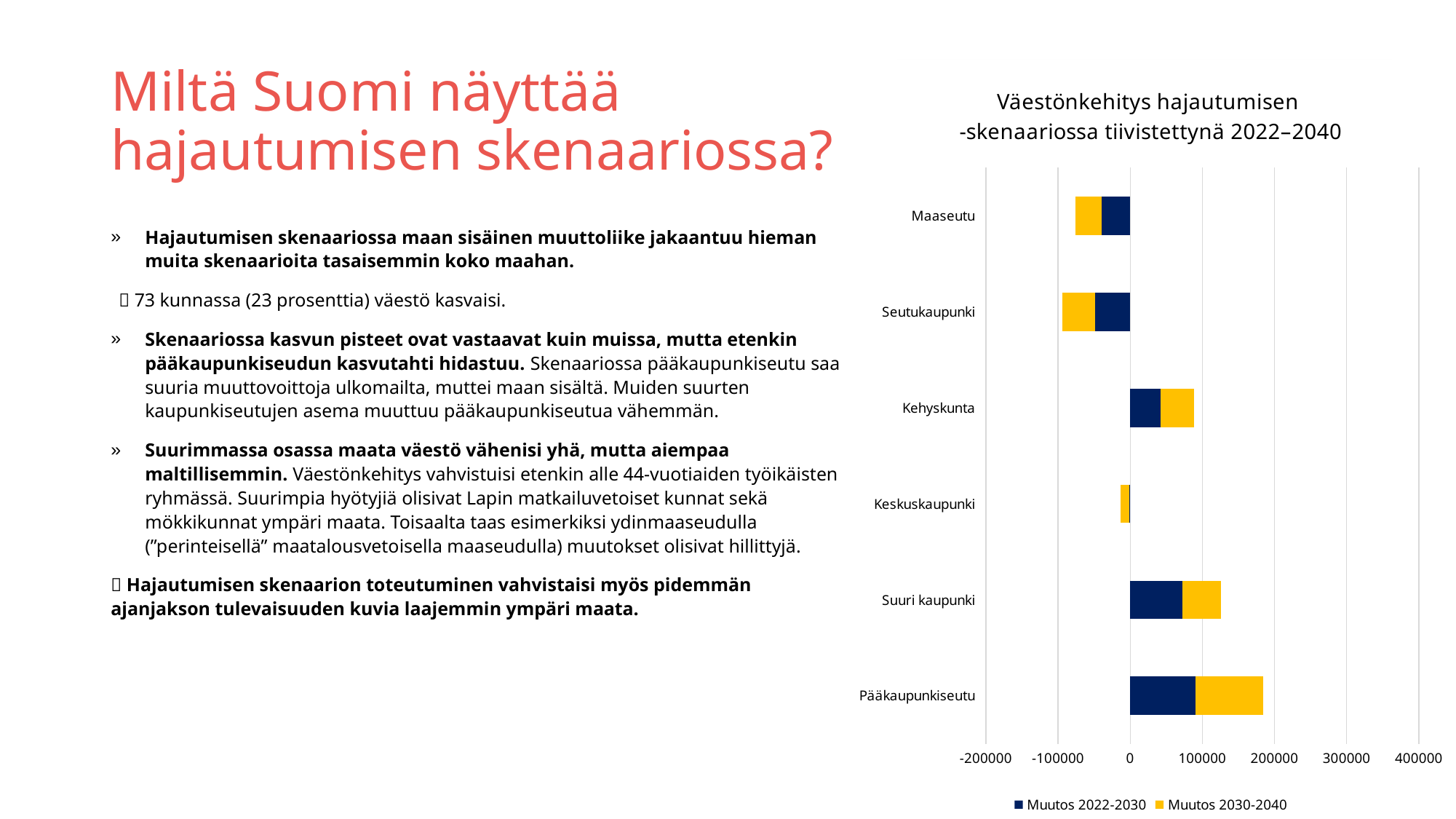
What is the title of the chart? Väestönkehitys hajautumisen -skenaariossa tiivistettynä 2022–2040 What kind of chart is shown on the slide? bar chart Which category has the largest total positive population change in the chart? Pääkaupunkiseutu Is the total value for Suuri kaupunki greater or less than 200000? less Which category has the most negative total population change in the chart? Seutukaupunki Is the total value for Pääkaupunkiseutu greater or less than 100000? greater How many categories are shown on the chart's vertical axis? 6 Is the total value for Maaseutu greater or less than -100000? greater Which has a larger total population change, Suuri kaupunki or Kehyskunta? Suuri kaupunki Which series is shown in yellow in the chart? Muutos 2030-2040 How many series does the chart's legend list? 2